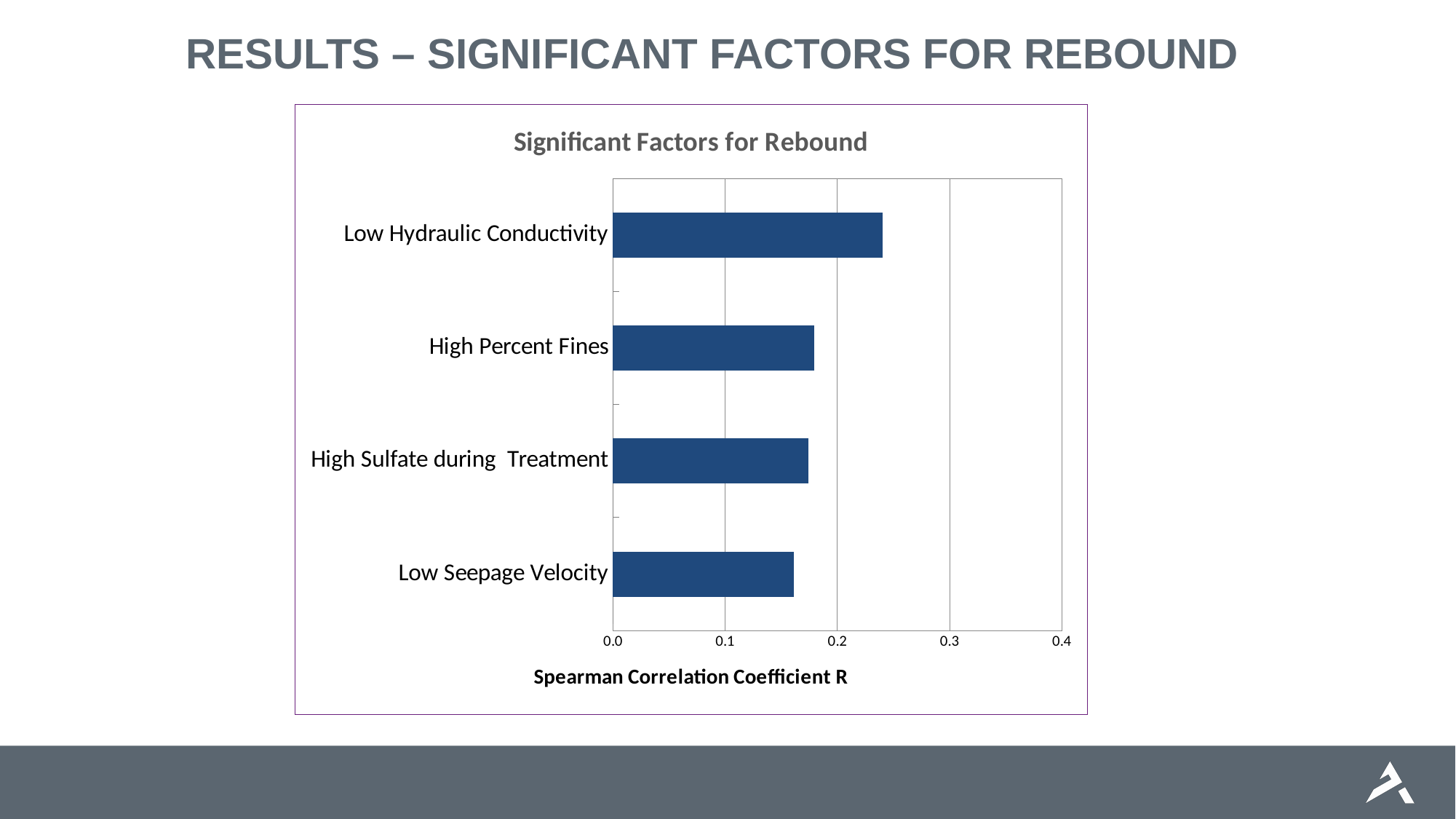
Is the value for Low Hydraulic Conductivity greater or less than 0.2? greater Which is larger, the value for High Percent Fines or the value for Low Seepage Velocity? High Percent Fines What kind of chart is shown on the slide? bar chart Which is larger, the value for Low Hydraulic Conductivity or the value for Low Seepage Velocity? Low Hydraulic Conductivity Is the value for Low Seepage Velocity greater or less than 0.2? less How many factors are plotted in the chart? 4 What is the title of the chart? Significant Factors for Rebound What is the label of the horizontal axis? Spearman Correlation Coefficient R Which factor has the highest Spearman correlation coefficient? Low Hydraulic Conductivity Is the value for High Percent Fines greater or less than 0.2? less